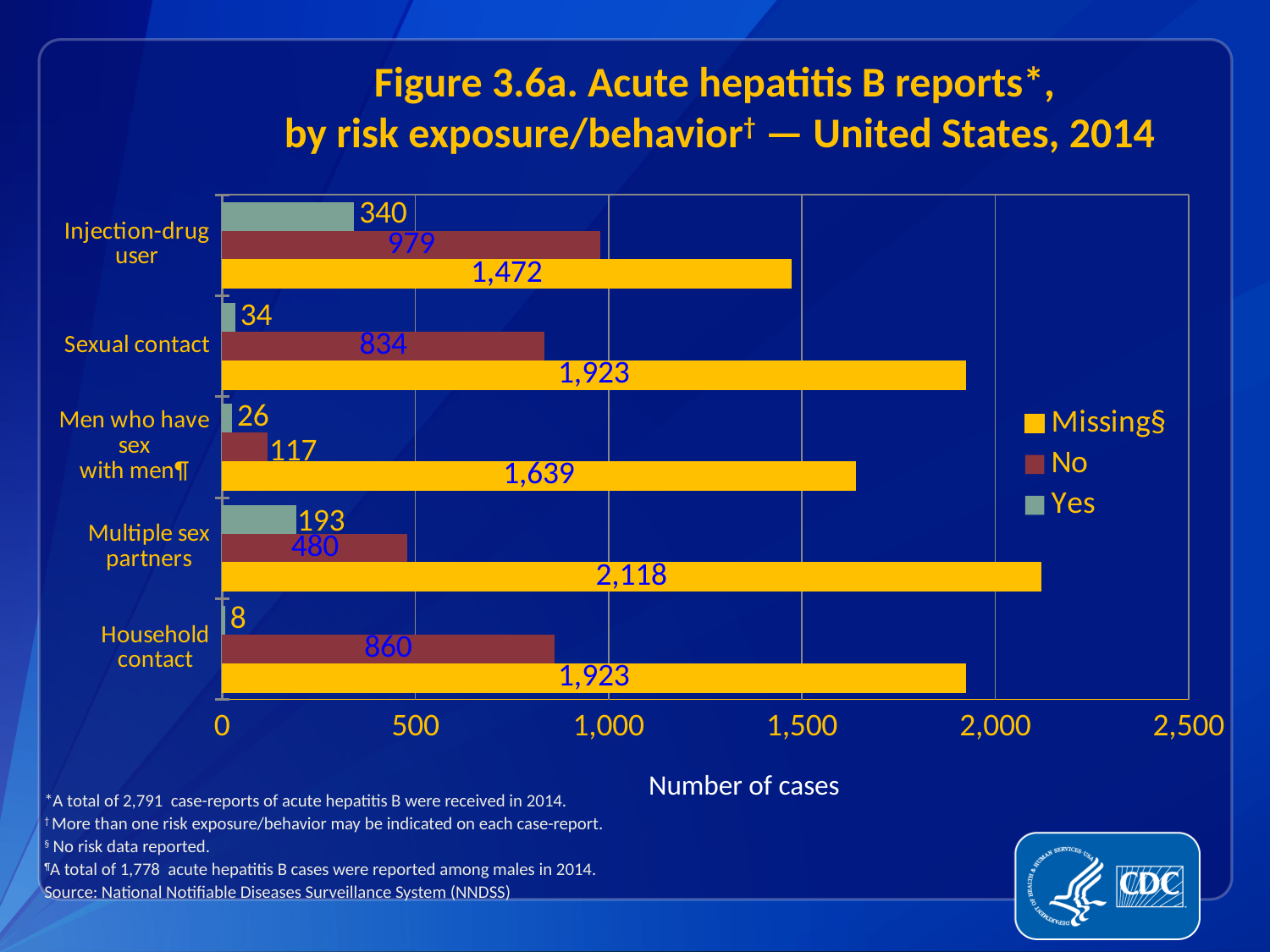
How many series does the legend list? 3 What is the 'Missing' value for Multiple sex partners? 2,118 What is the difference between the 'No' values for Injection-drug user and Multiple sex partners? 499 What kind of chart is shown on the slide? bar chart Which category has the highest 'Yes' value? Injection-drug user What is the 'No' value for Household contact? 860 What is the 'Yes' value for Injection-drug user? 340 Which category has the lowest 'No' value? Men who have sex with men Which is larger, the 'Missing' value for Injection-drug user or for Men who have sex with men? Men who have sex with men What is the label of the x axis? Number of cases How many risk exposure/behavior categories are shown on the chart? 5 Which category has the lowest 'Yes' value? Household contact